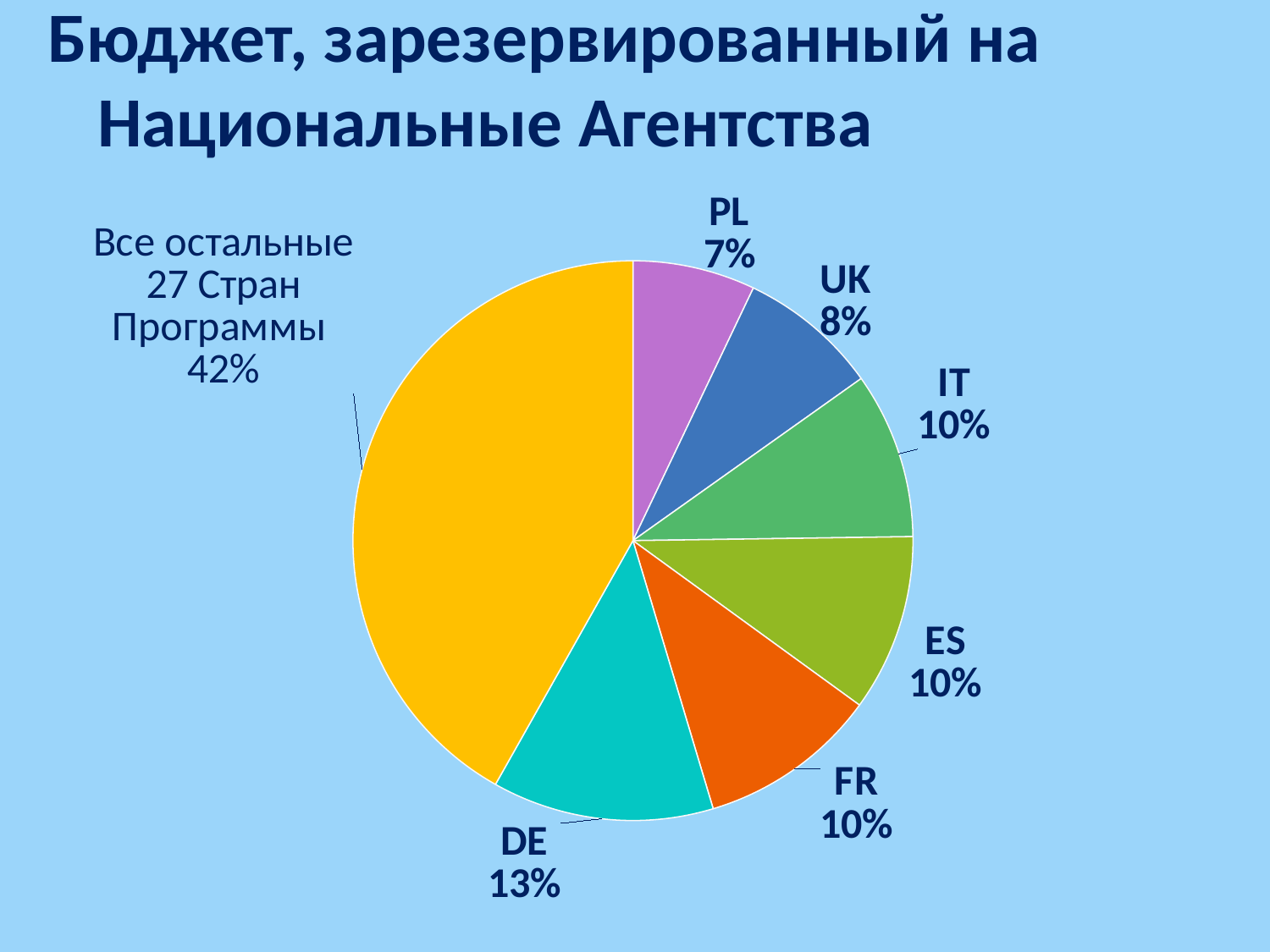
What share of the budget is reserved for DE? 13% What share is shown for 'Все остальные 27 Стран Программы'? 42% What is the title of the slide? Бюджет, зарезервированный на Национальные Агентства What is the difference between the shares for DE and PL? 6% Which slice of the pie is the largest? Все остальные 27 Стран Программы What share of the budget is reserved for PL? 7% Which slice of the pie is the smallest? PL What share of the budget is reserved for UK? 8% What is the combined share of IT, ES and FR? 30% How many slices does the pie chart have? 7 What kind of chart is shown on the slide? Pie chart Which has a larger share, DE or UK? DE